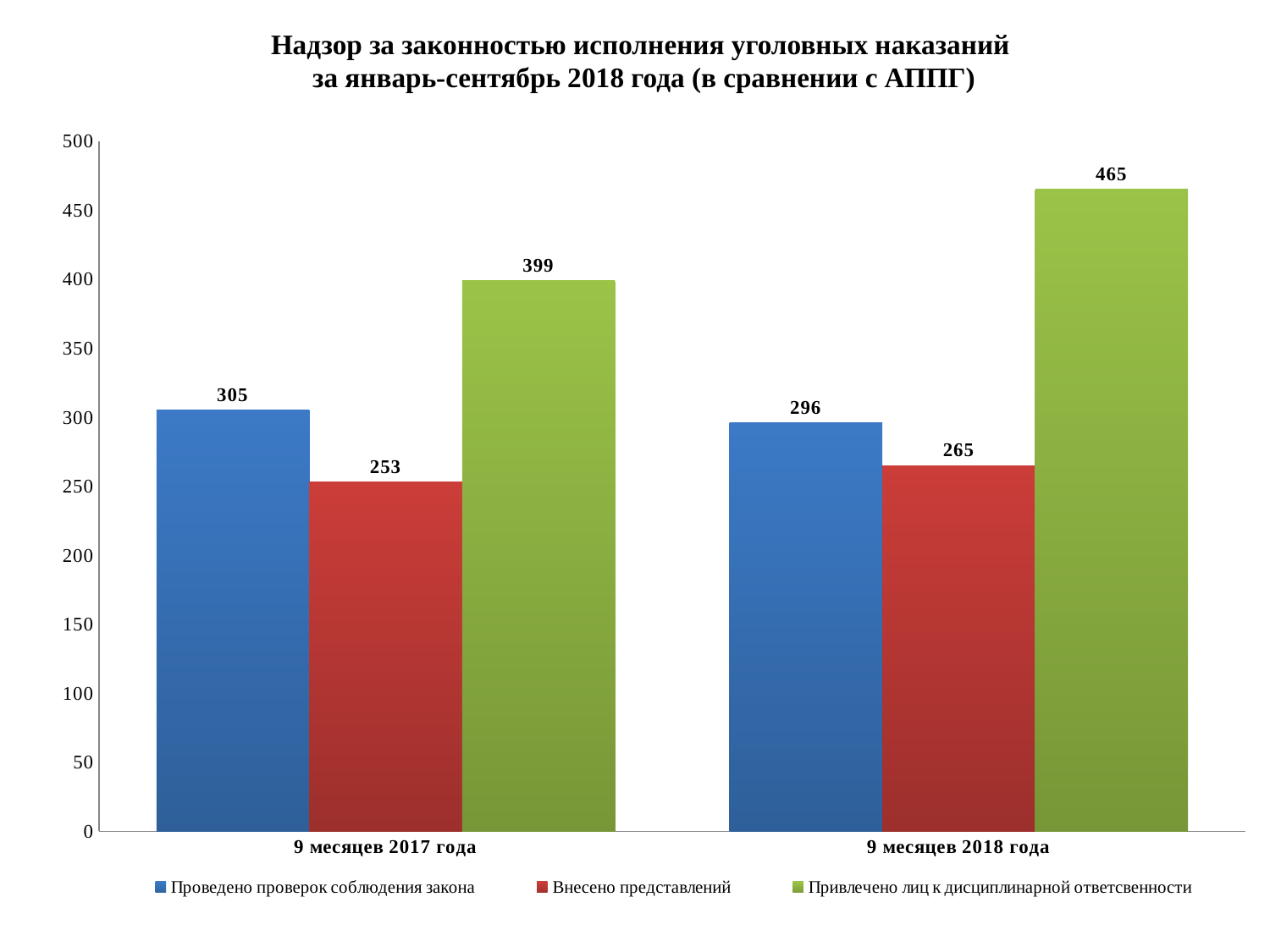
What is the value of "Внесено представлений" for "9 месяцев 2018 года"? 265 What is the value of "Привлечено лиц к дисциплинарной ответсвенности" for "9 месяцев 2017 года"? 399 Which series has the lowest value for "9 месяцев 2017 года"? Внесено представлений What is the value of "Проведено проверок соблюдения закона" for "9 месяцев 2017 года"? 305 Which series has the highest value for "9 месяцев 2018 года"? Привлечено лиц к дисциплинарной ответсвенности Which is larger: "Проведено проверок соблюдения закона" for "9 месяцев 2017 года" or for "9 месяцев 2018 года"? 9 месяцев 2017 года What colour are the bars for "Внесено представлений"? red How many categories are shown on the x axis? 2 Is the value of "Внесено представлений" for "9 месяцев 2017 года" greater or less than 300? less What kind of chart is shown on the slide? bar chart What is the difference between the "Привлечено лиц к дисциплинарной ответсвенности" values for "9 месяцев 2018 года" and "9 месяцев 2017 года"? 66 How many series does the legend list? 3